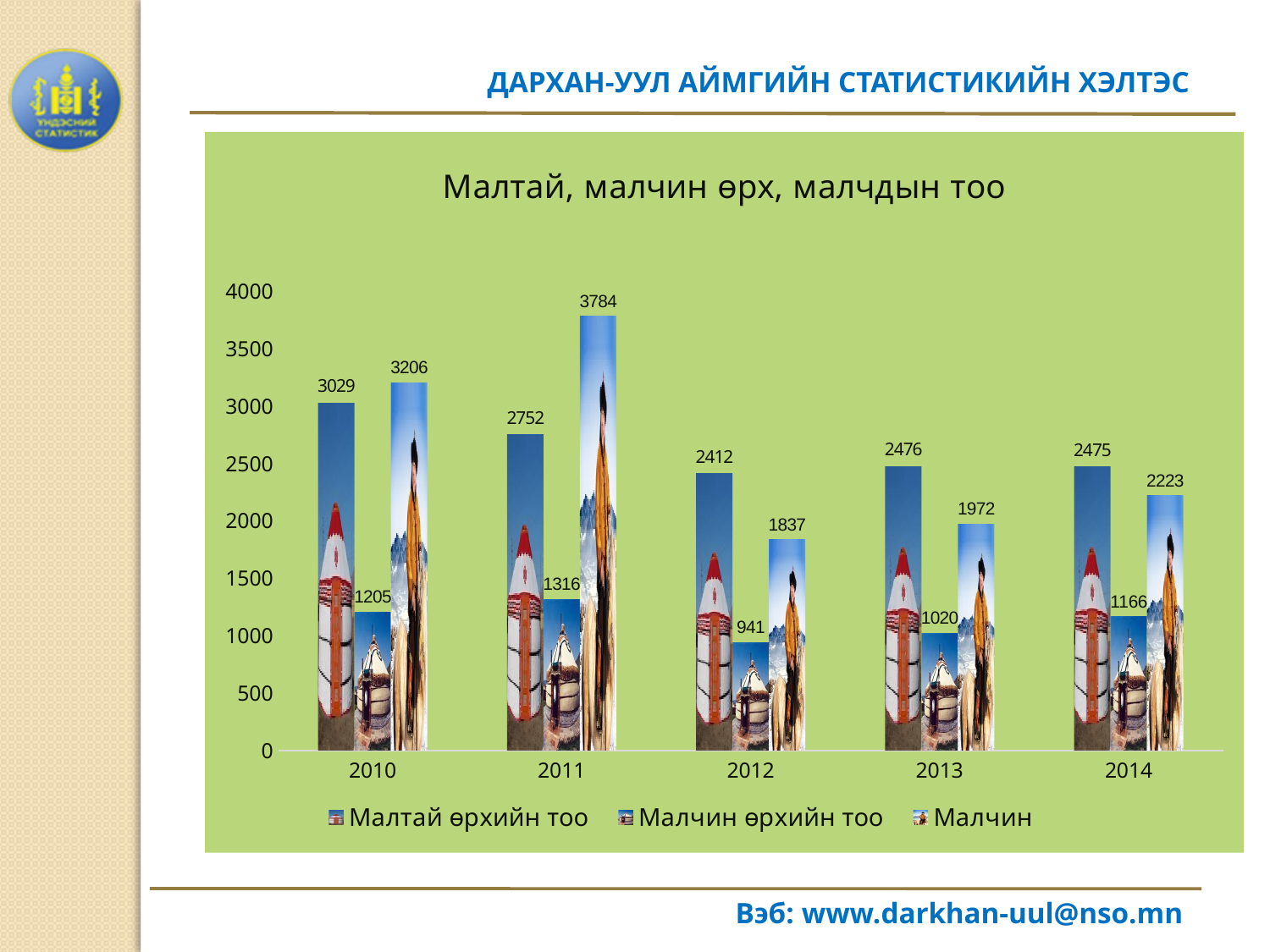
In which year is the Малчин series highest? 2011 How many years are shown on the x axis? 5 What is the title of the chart? Малтай, малчин өрх, малчдын тоо How many series does the legend list? 3 What is the value of Малчин in 2014? 2223 In which year is the Малчин өрхийн тоо series lowest? 2012 What is the value of Малчин өрхийн тоо in 2012? 941 What kind of chart is shown on the slide? bar chart What is the value of Малтай өрхийн тоо in 2011? 2752 Does the Малтай өрхийн тоо series rise or fall from 2010 to 2012? fall Which is larger in 2012: Малтай өрхийн тоо or Малчин? Малтай өрхийн тоо What is the difference between Малчин and Малчин өрхийн тоо in 2010? 2001